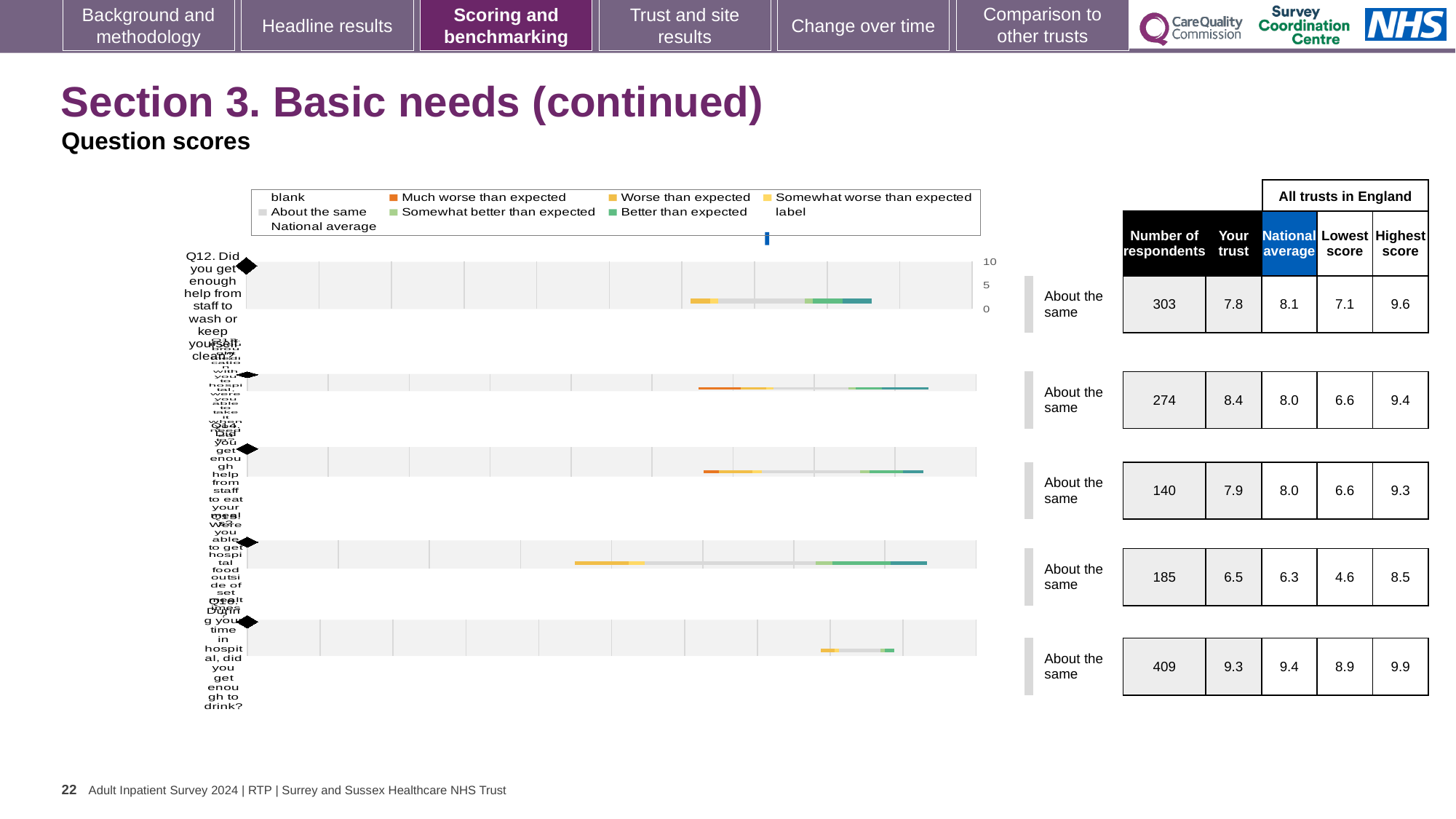
For Q12, which is larger: the 'Your trust' score or the national average? national average What colour does the legend use for 'Better than expected'? green What benchmark category is shown for Q12 (help from staff to wash or keep yourself clean)? About the same What kind of chart is used to show the question scores on this slide? bar chart For Q12 (help from staff to wash or keep yourself clean), what is the national average score? 8.1 For Q12, what is the difference between the national average (8.1) and the 'Your trust' score (7.8)? 0.3 How many respondents answered Q12 (help from staff to wash or keep yourself clean)? 303 How many question rows (bars) are plotted on the slide? 5 What is the lowest score among all trusts in England for Q12? 7.1 What is the highest score among all trusts in England for Q12? 9.6 What colour does the legend use for 'Much worse than expected'? orange For Q12 (help from staff to wash or keep yourself clean), what is the 'Your trust' score? 7.8